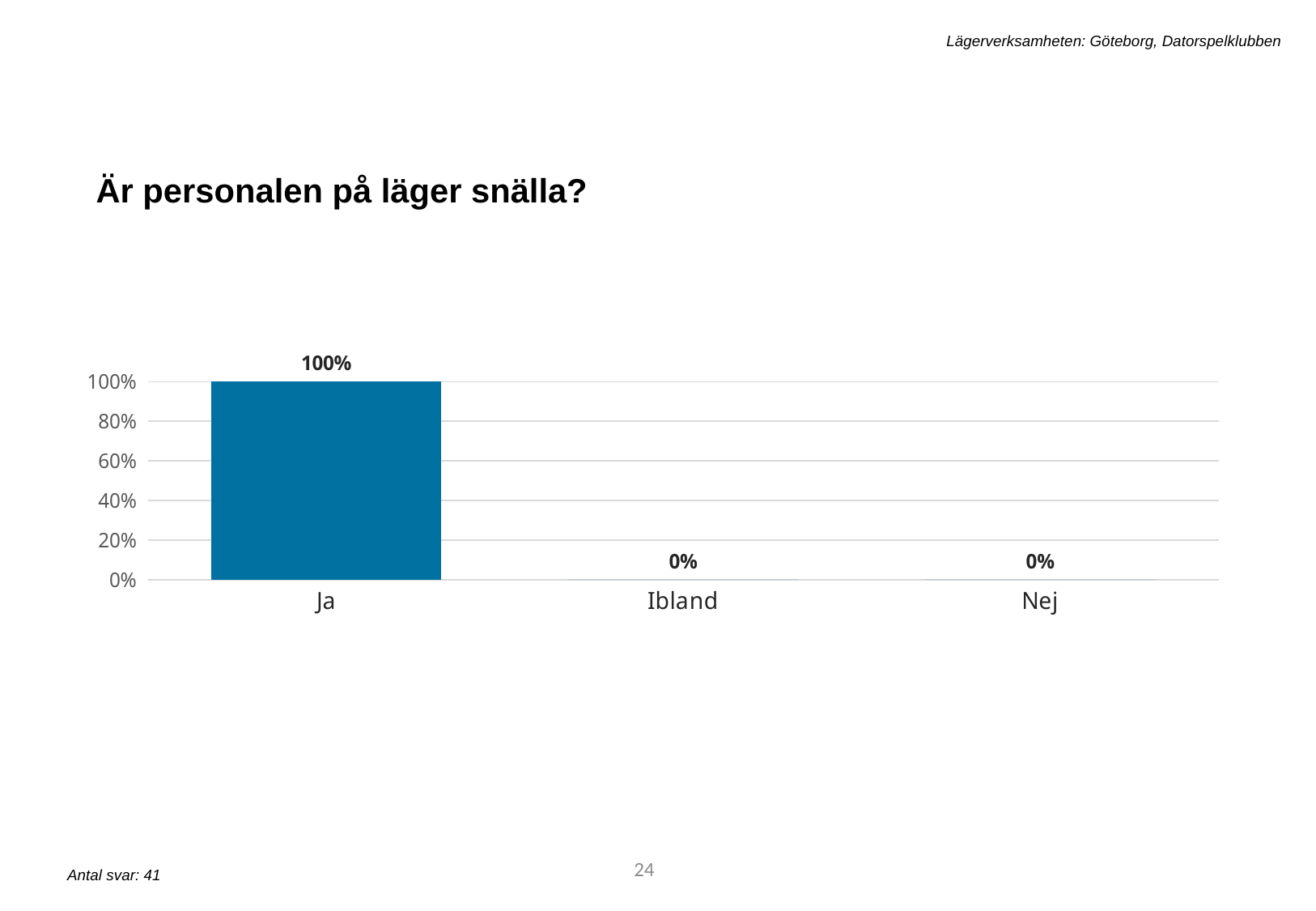
What kind of chart is shown on the slide? bar chart What is the value for Nej? 0% Which is larger, the value for Ja or the value for Ibland? Ja What is the title of the chart? Är personalen på läger snälla? What is the highest tick value shown on the y axis? 100% Is the value for Ja greater or less than 80%? greater What is the value for Ibland? 0% What is the difference between the values for Ja and Nej? 100% How many categories are shown on the x axis? 3 What is the value for Ja? 100% How many responses (Antal svar) does the slide report? 41 Which category has the highest value? Ja